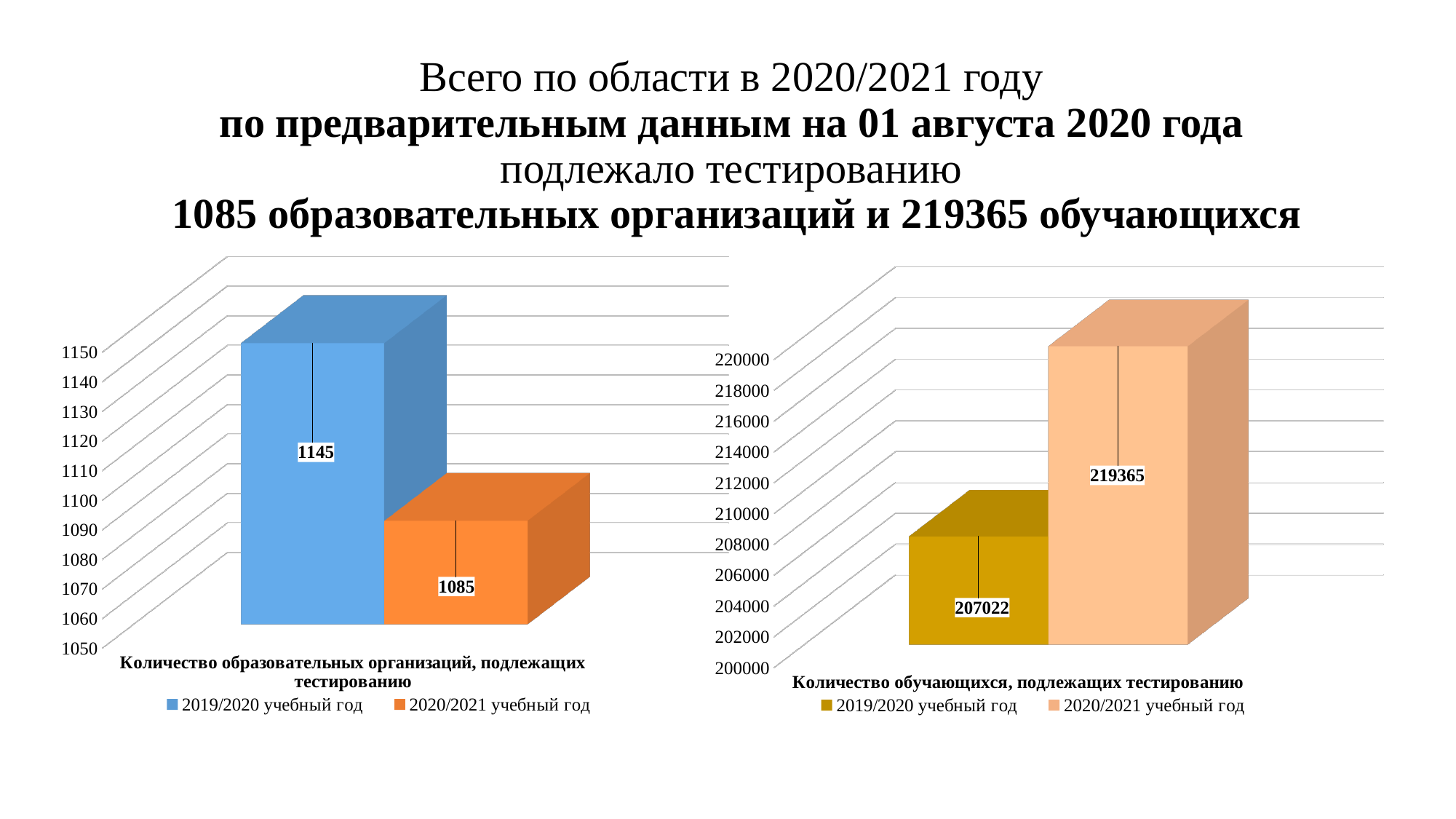
In the left chart (Количество образовательных организаций, подлежащих тестированию), what is the value for 2020/2021 учебный год? 1085 In the right chart (Количество обучающихся, подлежащих тестированию), what is the difference between the 2020/2021 and 2019/2020 values? 12343 What kind of chart is the right chart (Количество обучающихся, подлежащих тестированию)? bar chart In the left chart (Количество образовательных организаций, подлежащих тестированию), what is the value for 2019/2020 учебный год? 1145 In the right chart (Количество обучающихся, подлежащих тестированию), is the value for 2020/2021 учебный год larger or smaller than the value for 2019/2020 учебный год? larger In the left chart (Количество образовательных организаций, подлежащих тестированию), which series has the higher value? 2019/2020 учебный год In the right chart (Количество обучающихся, подлежащих тестированию), what is the value for 2019/2020 учебный год? 207022 How many series does the legend of the left chart list? 2 In the right chart (Количество обучающихся, подлежащих тестированию), what is the value for 2020/2021 учебный год? 219365 In the left chart, what colour is the bar for 2020/2021 учебный год? orange In the left chart (Количество образовательных организаций, подлежащих тестированию), what is the difference between the 2019/2020 and 2020/2021 values? 60 In the right chart (Количество обучающихся, подлежащих тестированию), which series has the lower value? 2019/2020 учебный год